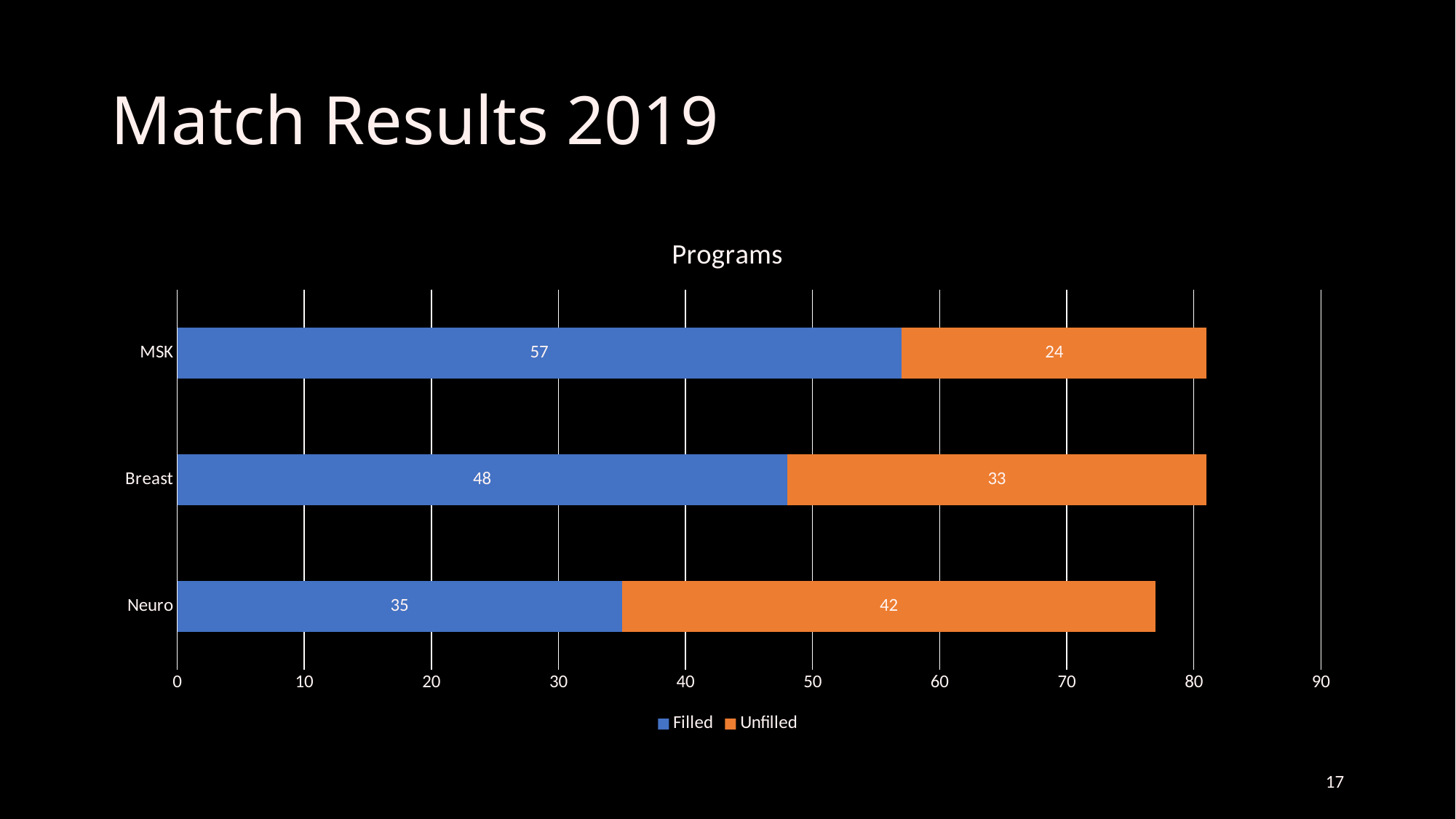
What is the total of the stacked bar for MSK? 81 Which is larger, the Filled value for Breast or the Unfilled value for Breast? Filled What is the Filled value for MSK? 57 Which category has the lowest Unfilled value? MSK What is the total of the stacked bar for Neuro? 77 What is the Unfilled value for Breast? 33 Which category has the highest Filled value? MSK What is the difference between the Filled values for MSK and Neuro? 22 How many categories are shown on the chart? 3 What is the Unfilled value for Neuro? 42 What kind of chart is shown on the slide? Stacked bar chart How many series does the legend list? 2